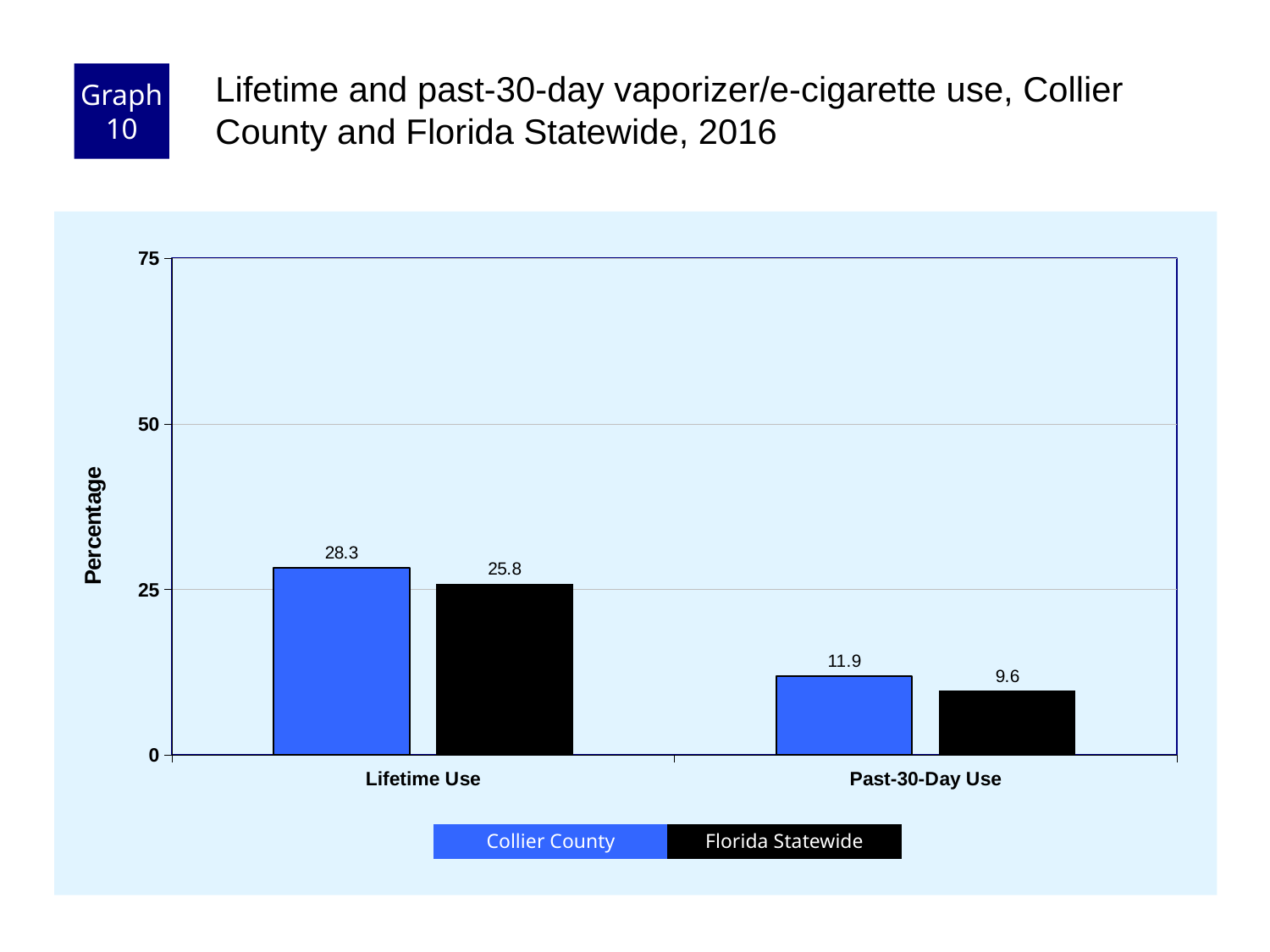
Which bar has the highest value on the chart? Collier County, Lifetime Use What is the Collier County value for Past-30-Day Use? 11.9 What is the Florida Statewide value for Past-30-Day Use? 9.6 What is the difference between the Collier County and Florida Statewide values for Past-30-Day Use? 2.3 Is the Collier County value for Lifetime Use greater or less than 25? greater Which bar has the lowest value on the chart? Florida Statewide, Past-30-Day Use What is the difference between the Collier County and Florida Statewide values for Lifetime Use? 2.5 What kind of chart is shown on the slide? Bar chart For Past-30-Day Use, which is larger: Collier County or Florida Statewide? Collier County What is the Florida Statewide value for Lifetime Use? 25.8 How many series does the legend list? 2 What is the Collier County value for Lifetime Use? 28.3